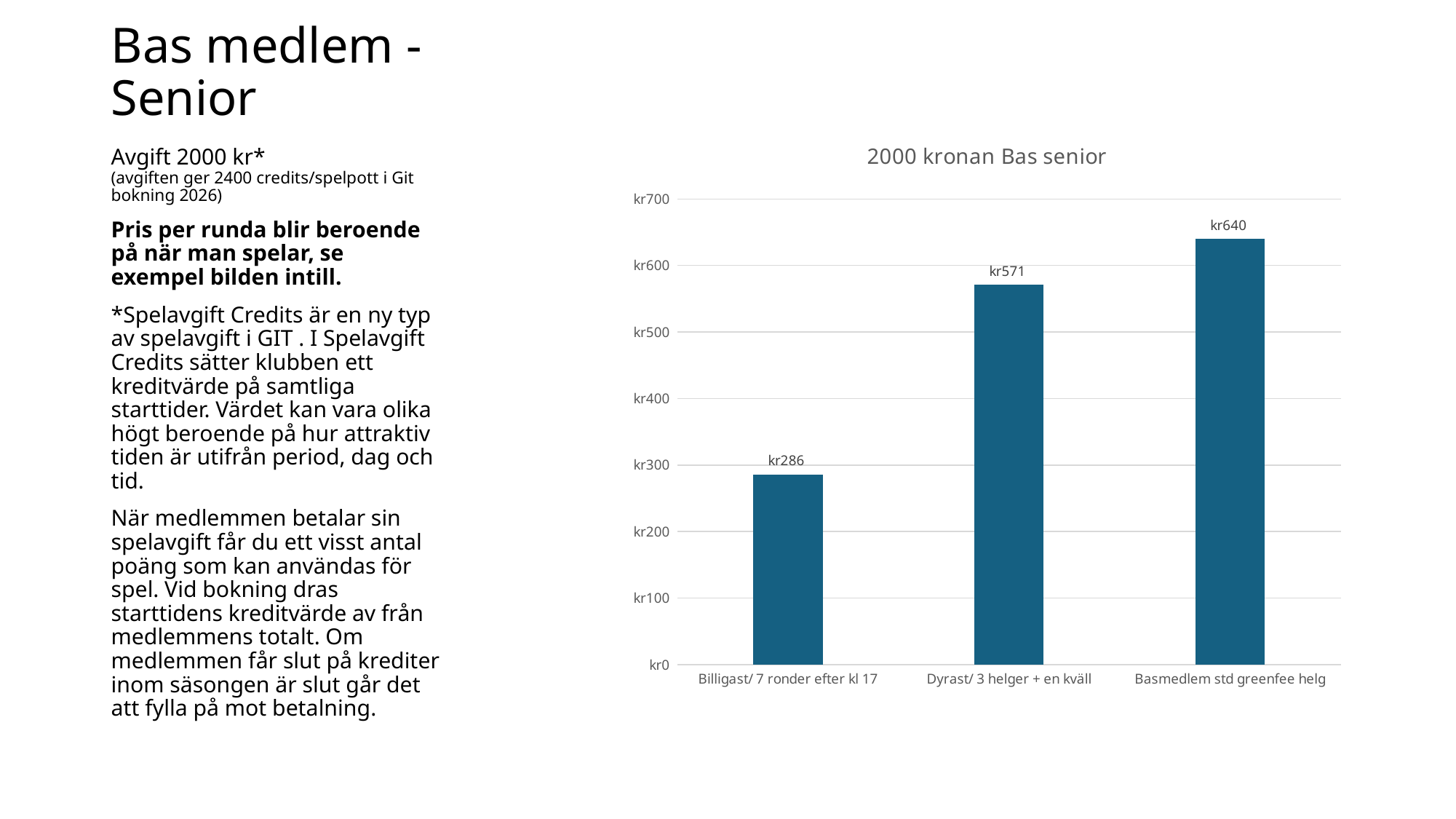
What is the value for "Billigast/ 7 ronder efter kl 17"? kr286 What is the difference between the values for "Dyrast/ 3 helger + en kväll" and "Billigast/ 7 ronder efter kl 17"? kr285 What is the title of the chart? 2000 kronan Bas senior What is the difference between the values for "Basmedlem std greenfee helg" and "Dyrast/ 3 helger + en kväll"? kr69 What is the value for "Basmedlem std greenfee helg"? kr640 Which category has the lowest value? Billigast/ 7 ronder efter kl 17 What is the value for "Dyrast/ 3 helger + en kväll"? kr571 How many categories are shown in the chart? 3 Which is larger, the value for "Dyrast/ 3 helger + en kväll" or "Billigast/ 7 ronder efter kl 17"? Dyrast/ 3 helger + en kväll What kind of chart is shown on the slide? Bar chart Is the value for "Dyrast/ 3 helger + en kväll" greater or less than kr500? greater Which category has the highest value? Basmedlem std greenfee helg